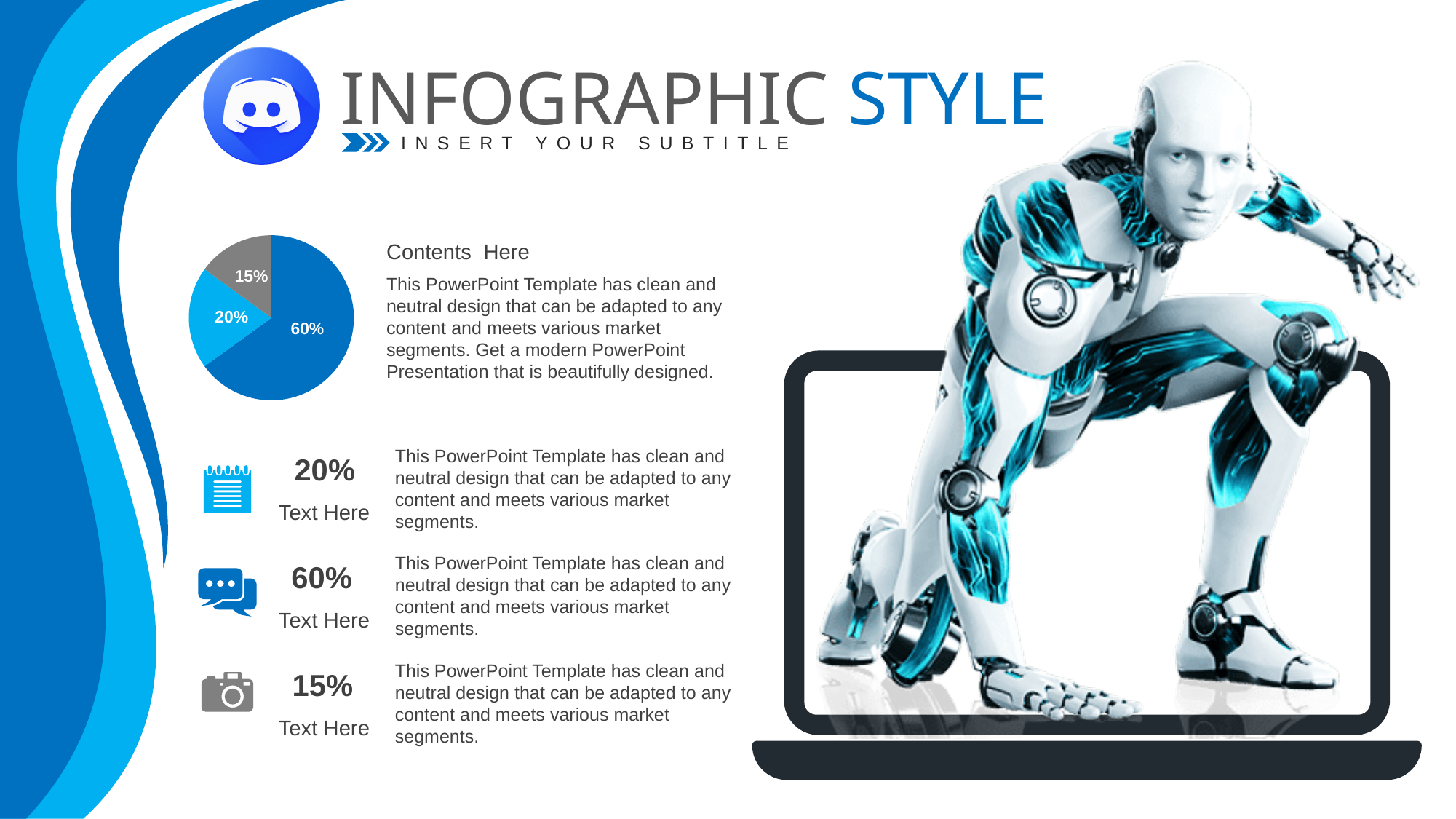
Which colour is the largest slice of the pie chart? dark blue What percentage is labelled on the light blue slice of the pie chart? 20% What percentage is labelled on the gray slice of the pie chart? 15% What is the smallest value labelled on the pie chart? 15% How many slices does the pie chart have? 3 What percentage is labelled on the dark blue slice of the pie chart? 60% Does the pie chart have a legend? No What kind of chart is shown on the left of the slide? pie chart What is the difference between the light blue slice and the gray slice on the pie chart? 5% Which slice of the pie chart is larger, the light blue one or the gray one? the light blue one What is the difference between the largest and smallest slice values on the pie chart? 45% What is the largest value labelled on the pie chart? 60%